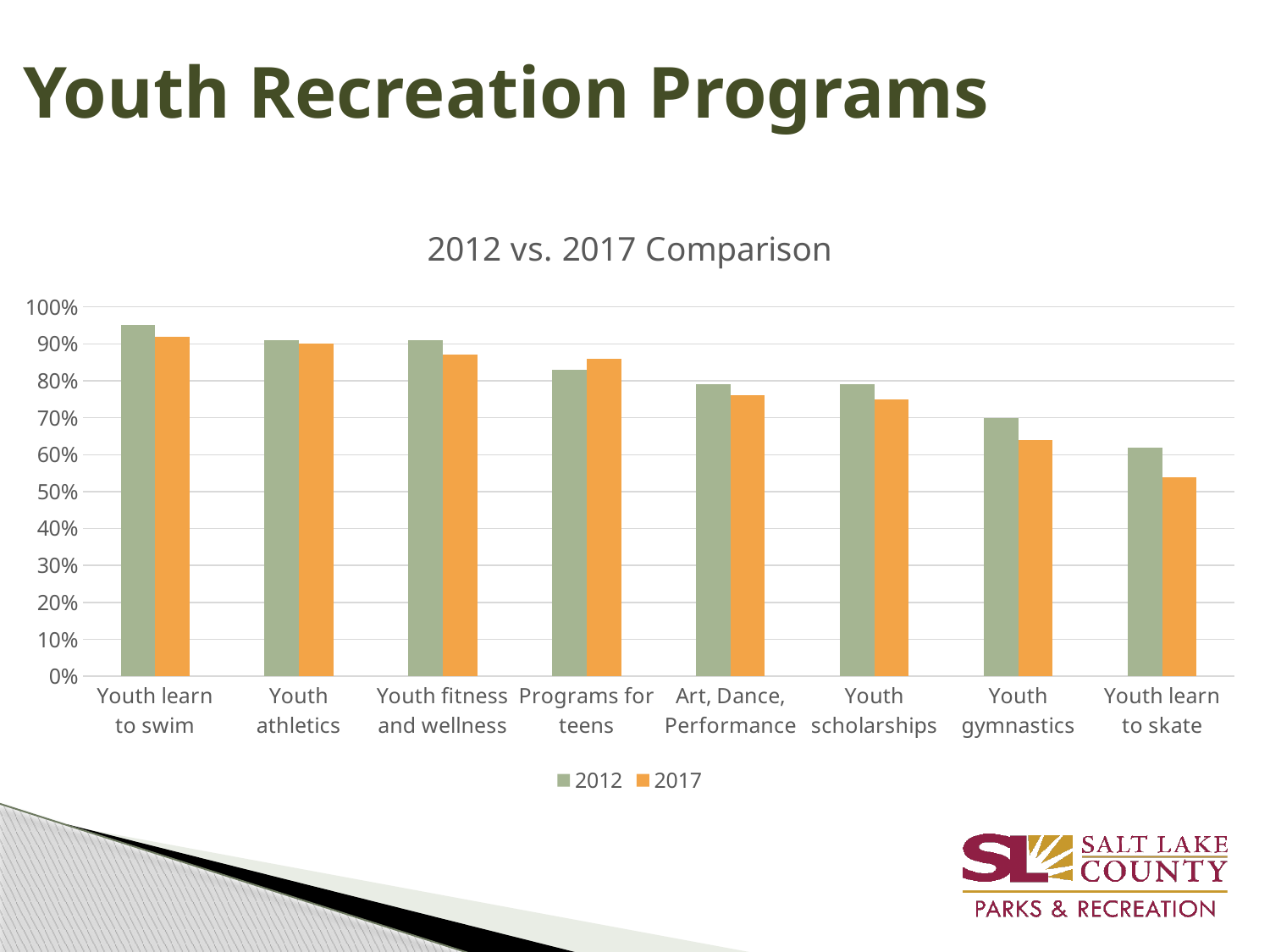
How many series does the chart's legend list? 2 What kind of chart is shown on the slide? bar chart Is the 2017 value for Youth learn to skate greater or less than 60%? less Which category has the lowest 2017 value? Youth learn to skate Do the 2012 values generally rise or fall moving left to right along the x axis? fall What is the title of the chart? 2012 vs. 2017 Comparison Is the 2012 value for Youth learn to swim greater or less than 90%? greater For Programs for teens, which is larger, the 2012 value or the 2017 value? 2017 Which series is shown in orange in the chart? 2017 How many program categories are shown on the x axis of the chart? 8 Which category has the highest 2012 value? Youth learn to swim For Youth gymnastics, which is larger, the 2012 value or the 2017 value? 2012